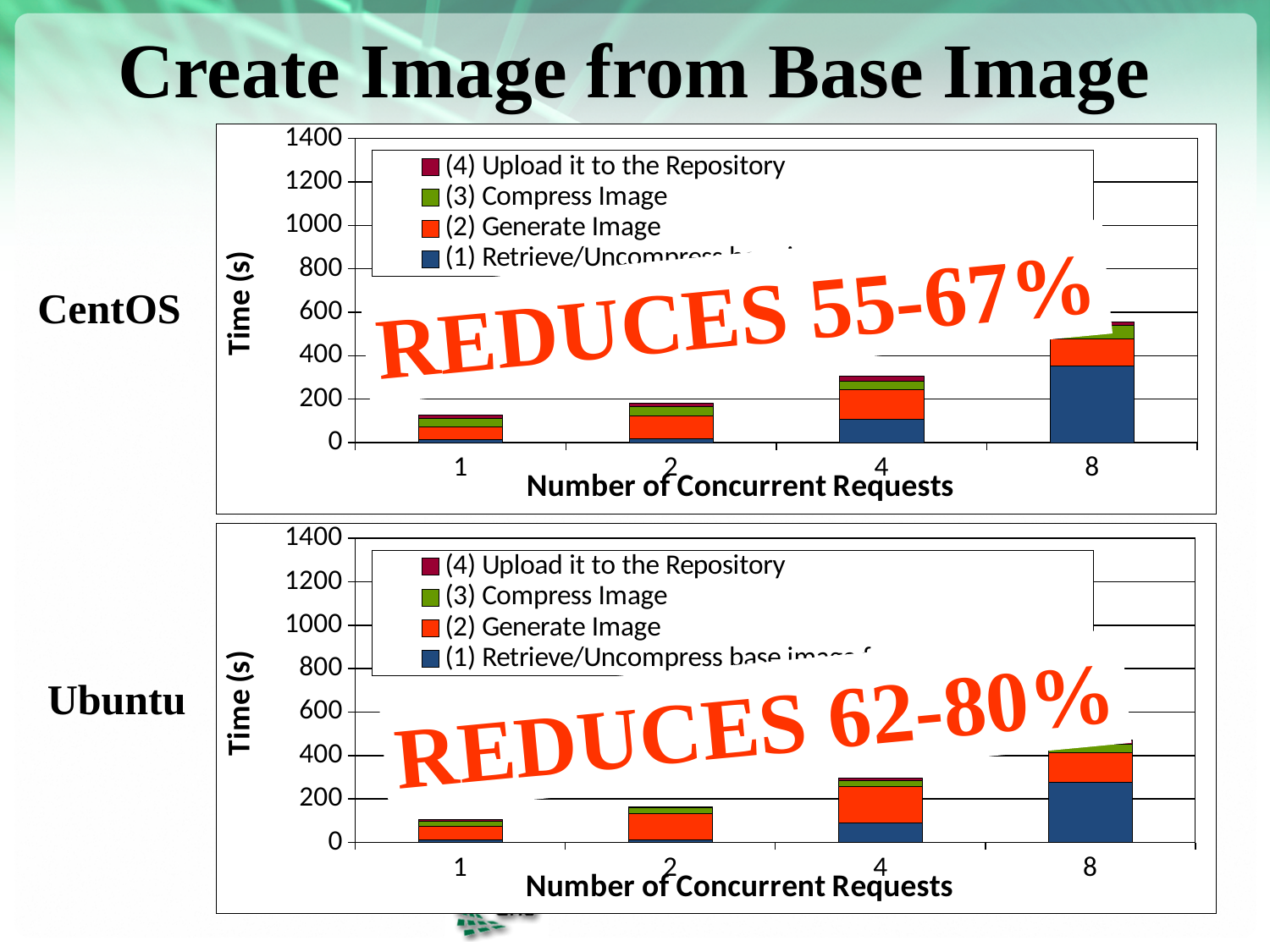
In the CentOS chart, is the total time for 1 concurrent request greater or less than 200? less In the Ubuntu chart, which number of concurrent requests has the lowest total time? 1 What is the y-axis title of the Ubuntu chart? Time (s) In the CentOS chart, which number of concurrent requests has the highest total time? 8 In the Ubuntu chart, is the total time for 4 concurrent requests greater or less than 400? less In the CentOS chart, which has the larger total time: 2 concurrent requests or 4 concurrent requests? 4 In the CentOS chart, is the total time for 8 concurrent requests greater or less than 400? greater What kind of chart is the top (CentOS) chart? stacked bar chart In the Ubuntu chart, does the total time rise or fall as the number of concurrent requests increases? rise In the Ubuntu chart, how many series does the legend list? 4 In the CentOS chart, how many categories are shown on the x axis? 4